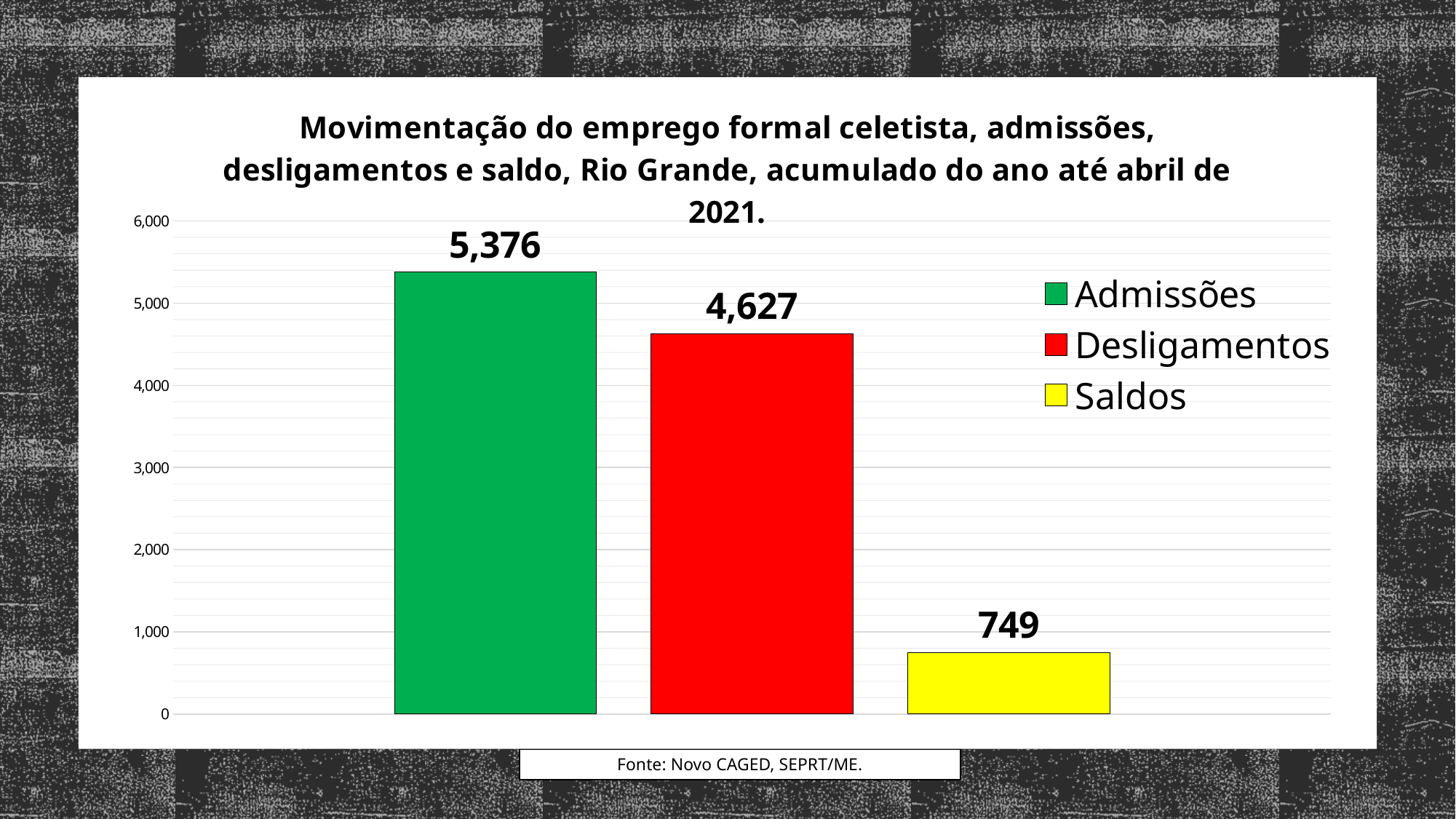
What is the difference between Desligamentos and Saldos? 3,878 What kind of chart is shown on the slide? bar chart What is the difference between Admissões and Desligamentos? 749 How many series does the legend list? 3 Is the value for Saldos greater or less than 1,000? less What colour is the bar for Desligamentos? red What is the value for Desligamentos? 4,627 Which is larger, Admissões or Desligamentos? Admissões Which series has the lowest value? Saldos What is the value for Saldos? 749 Which series has the highest value? Admissões What is the value for Admissões? 5,376